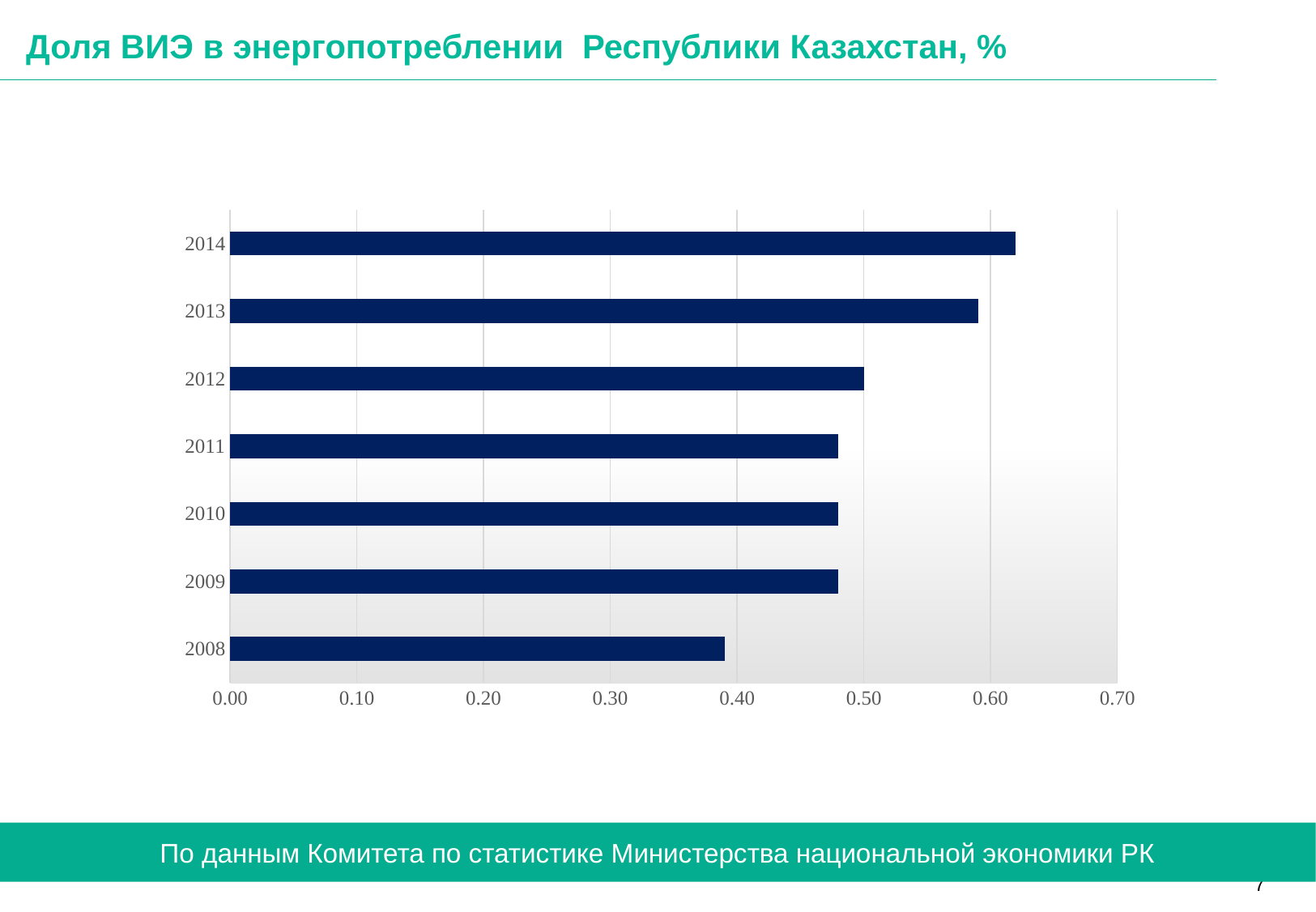
How many years are plotted in the chart? 7 Do the values generally rise or fall from 2008 to 2014? rise Is the value for 2013 greater or less than 0.60? less What kind of chart is shown on the slide? bar chart Which year has the lowest share of renewable energy in the chart? 2008 What is the title of the slide containing the chart? Доля ВИЭ в энергопотреблении Республики Казахстан, % Is the value for 2014 greater or less than 0.60? greater Which year has the larger value, 2008 or 2011? 2011 Is the value for 2008 greater or less than 0.40? less Which year has the larger value, 2013 or 2012? 2013 Which year has the highest share of renewable energy in the chart? 2014